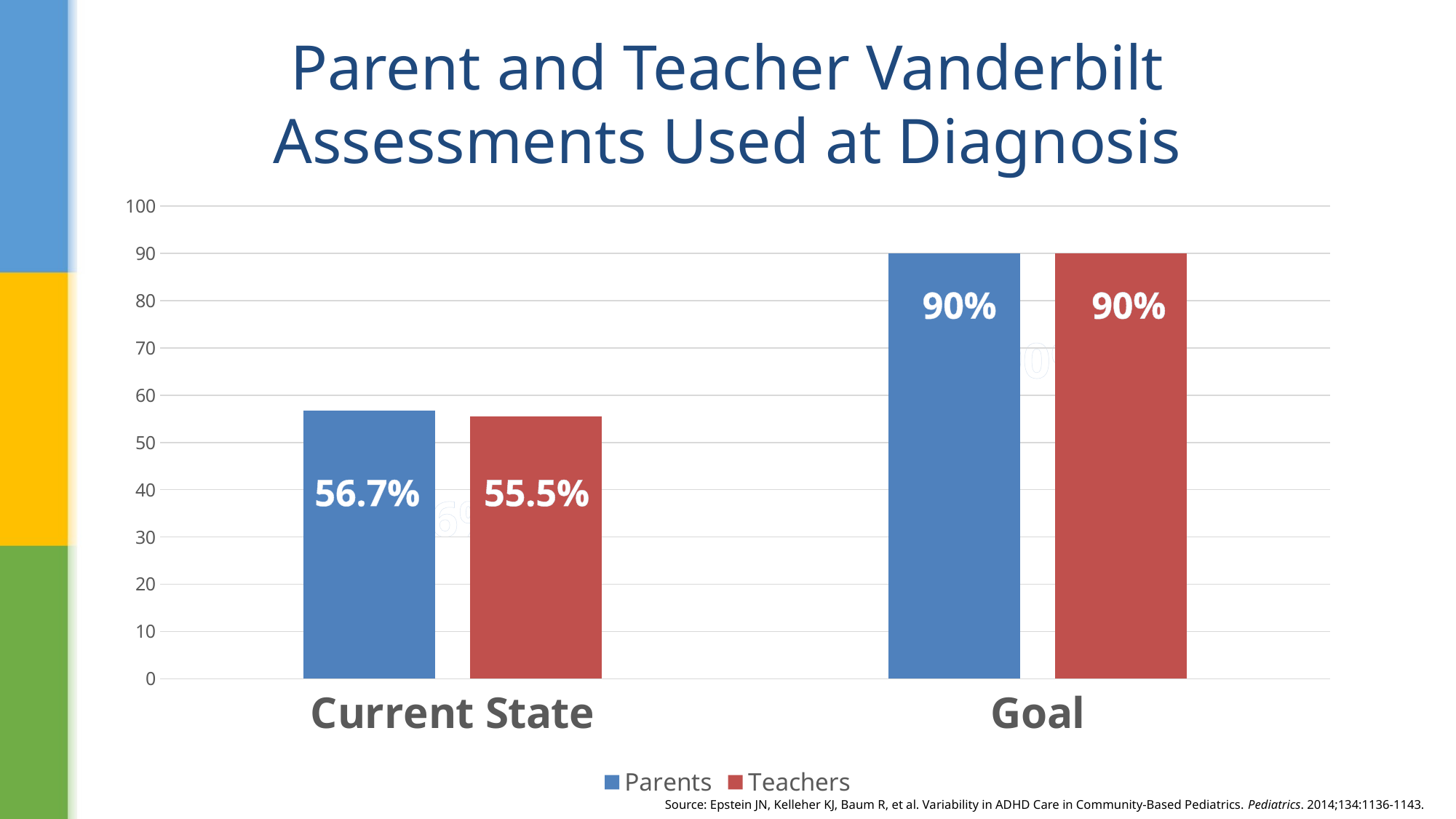
How many series does the legend list? 2 What is the value for Teachers in the Goal category? 90% Which category has the higher value for Teachers, Current State or Goal? Goal What is the value for Teachers in the Current State category? 55.5% Is the value for Parents in the Current State category greater or less than 50? greater What is the value for Parents in the Current State category? 56.7% What kind of chart is shown on the slide? Bar chart What is the difference between the Goal and Current State values for Parents? 33.3% How many categories are shown on the x axis? 2 What colour represents the Teachers series? Red What is the difference between the Parents and Teachers values in the Current State category? 1.2% What is the value for Parents in the Goal category? 90%